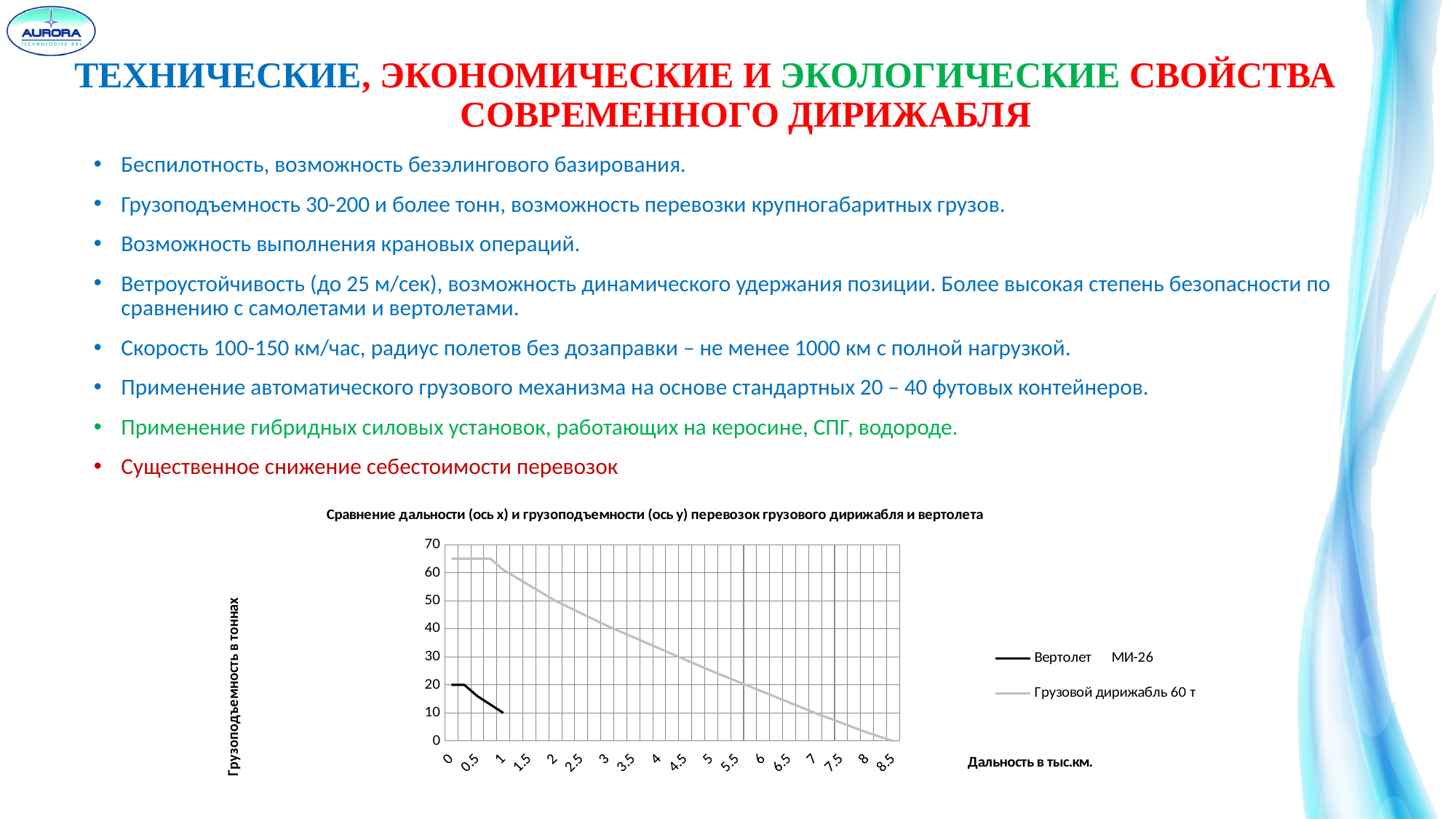
At a range of 0, which series has the higher payload: Вертолет МИ-26 or Грузовой дирижабль 60 т? Грузовой дирижабль 60 т Is the value for Грузовой дирижабль 60 т at a range of 0 greater or less than 60? greater What kind of chart is shown on the slide? line chart What is the payload value for Вертолет МИ-26 at a range of 1 on the chart? 10 Do the values for Грузовой дирижабль 60 т rise or fall as range increases along the x axis? fall What is the payload value for Грузовой дирижабль 60 т at a range of 8.5 on the chart? 0 What are the two series named in the chart legend? Вертолет МИ-26 and Грузовой дирижабль 60 т Is the value for Грузовой дирижабль 60 т at a range of 4 greater or less than 40? less What is the label of the vertical axis of the chart? Грузоподъемность в тоннах How many tick marks are labelled on the x axis of the chart? 18 How many series does the chart legend list? 2 What is the payload value for Вертолет МИ-26 at a range of 0 on the chart? 20